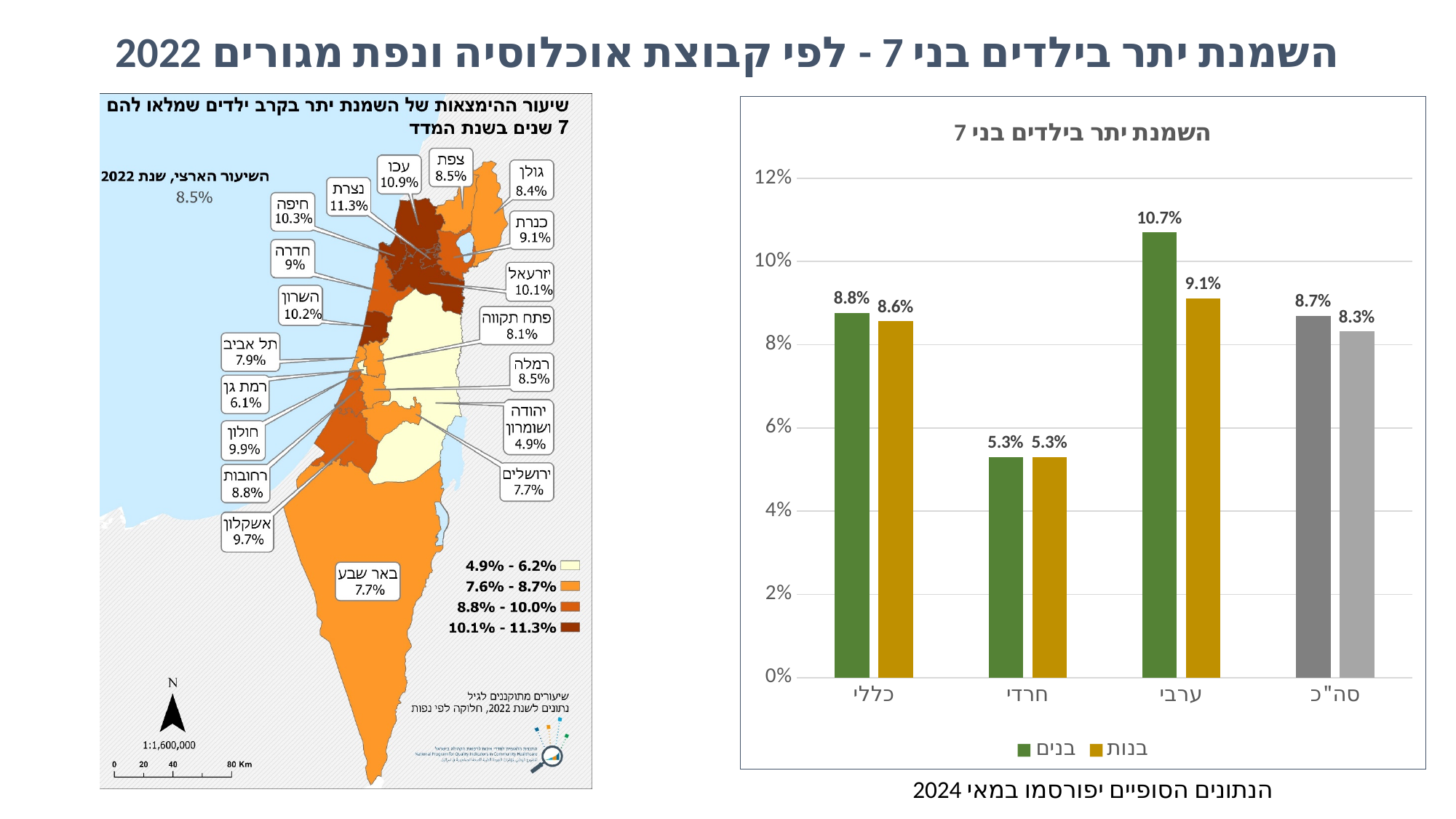
In the bar chart titled 'השמנת יתר בילדים בני 7', is the value for בנים in the ערבי category greater or less than 10%? greater In the bar chart titled 'השמנת יתר בילדים בני 7', what is the value for בנים in the ערבי category? 10.7% What kind of chart is the chart on the right side of the slide? Bar chart In the map on the left side of the slide, what is the value shown for נצרת? 11.3% In the bar chart titled 'השמנת יתר בילדים בני 7', what is the difference between the בנים and בנות values in the ערבי category? 1.6% In the bar chart titled 'השמנת יתר בילדים בני 7', what is the value for בנות in the סה"כ category? 8.3% In the bar chart titled 'השמנת יתר בילדים בני 7', which category has the highest value for בנים? ערבי In the bar chart titled 'השמנת יתר בילדים בני 7', which is larger: the בנים value for כללי or the בנים value for סה"כ? כללי In the bar chart titled 'השמנת יתר בילדים בני 7', how many categories are shown on the x axis? 4 In the bar chart titled 'השמנת יתר בילדים בני 7', which category has the lowest value for בנות? חרדי In the bar chart titled 'השמנת יתר בילדים בני 7', what is the value for בנות in the כללי category? 8.6% In the bar chart titled 'השמנת יתר בילדים בני 7', how many series does the legend list? 2